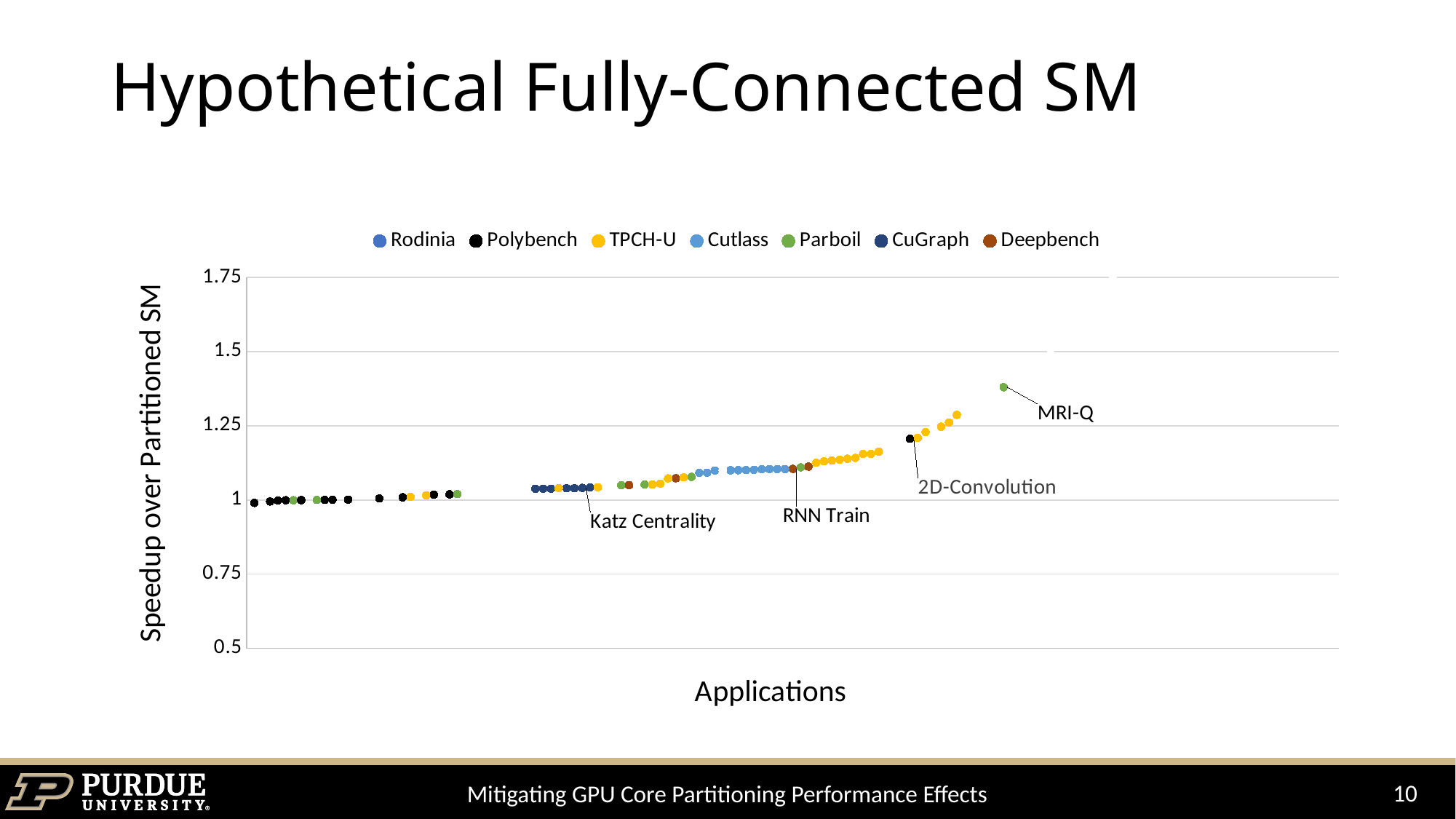
Which of the labelled applications has the highest speedup? MRI-Q Is the value for Katz Centrality greater or less than 1.25? less Is the value for 2D-Convolution greater or less than 1? greater What kind of chart is shown on the slide? scatter chart How many series does the legend list? 7 Is the value for RNN Train greater or less than 1? greater Which has the larger speedup, MRI-Q or 2D-Convolution? MRI-Q Do the plotted speedup values rise or fall from left to right along the x axis? rise What is the title of the x axis? Applications What is the title of the y axis? Speedup over Partitioned SM